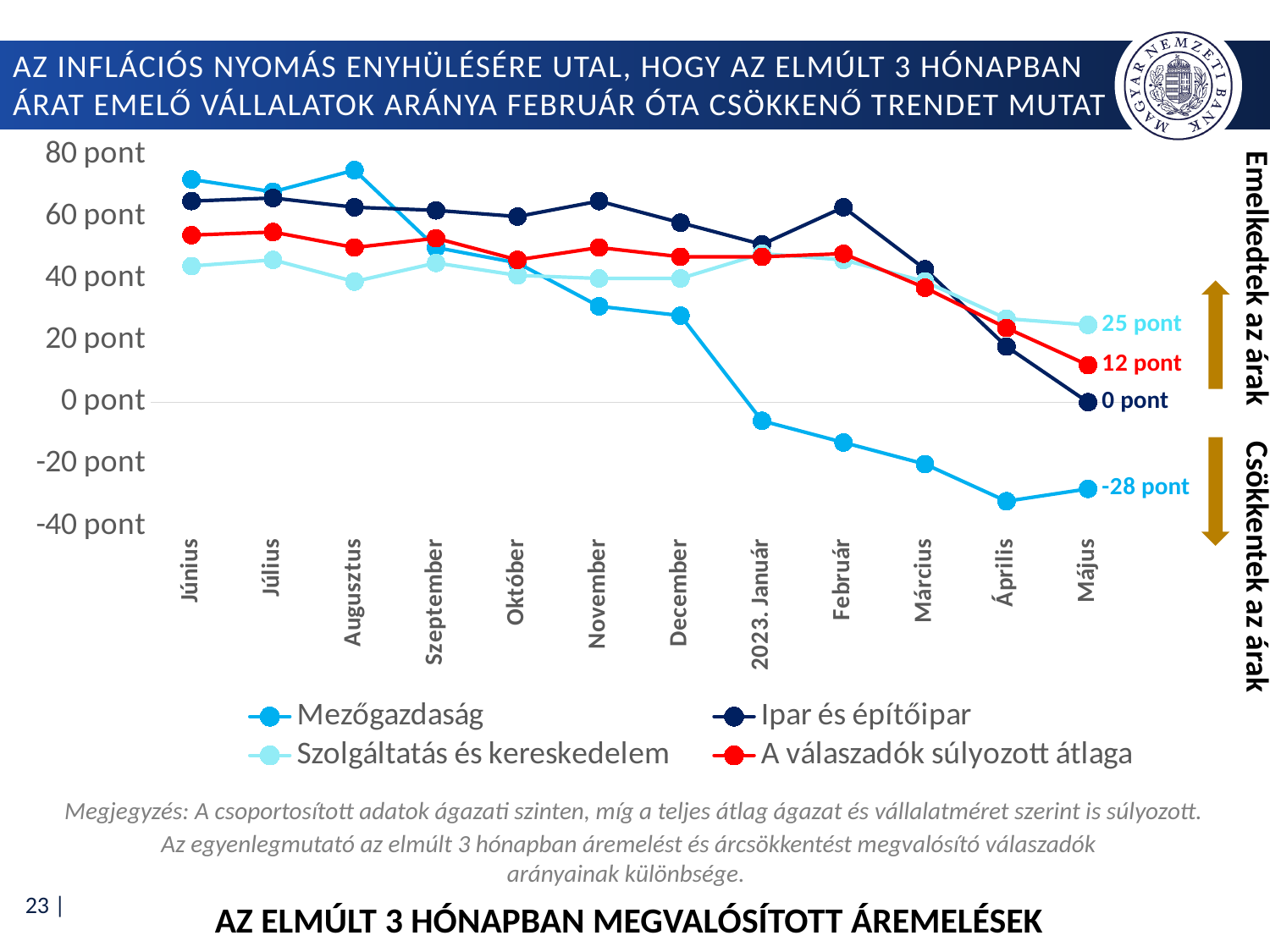
Which series has the highest value in Május? Szolgáltatás és kereskedelem How many series does the legend list? 4 What is the value for A válaszadók súlyozott átlaga in Május? 12 pont What is the difference between the Május values of Szolgáltatás és kereskedelem and A válaszadók súlyozott átlaga? 13 pont Does the Mezőgazdaság series rise or fall from Június to Május? fall What is the value for Szolgáltatás és kereskedelem in Május? 25 pont Which series has the lowest value in Május? Mezőgazdaság What is the value for Mezőgazdaság in Május? -28 pont Is the value for Mezőgazdaság in Április greater or less than -20 pont? less Is the value for Mezőgazdaság in Június greater or less than 60 pont? greater How many months are plotted on the x axis? 12 What is the value for Ipar és építőipar in Május? 0 pont